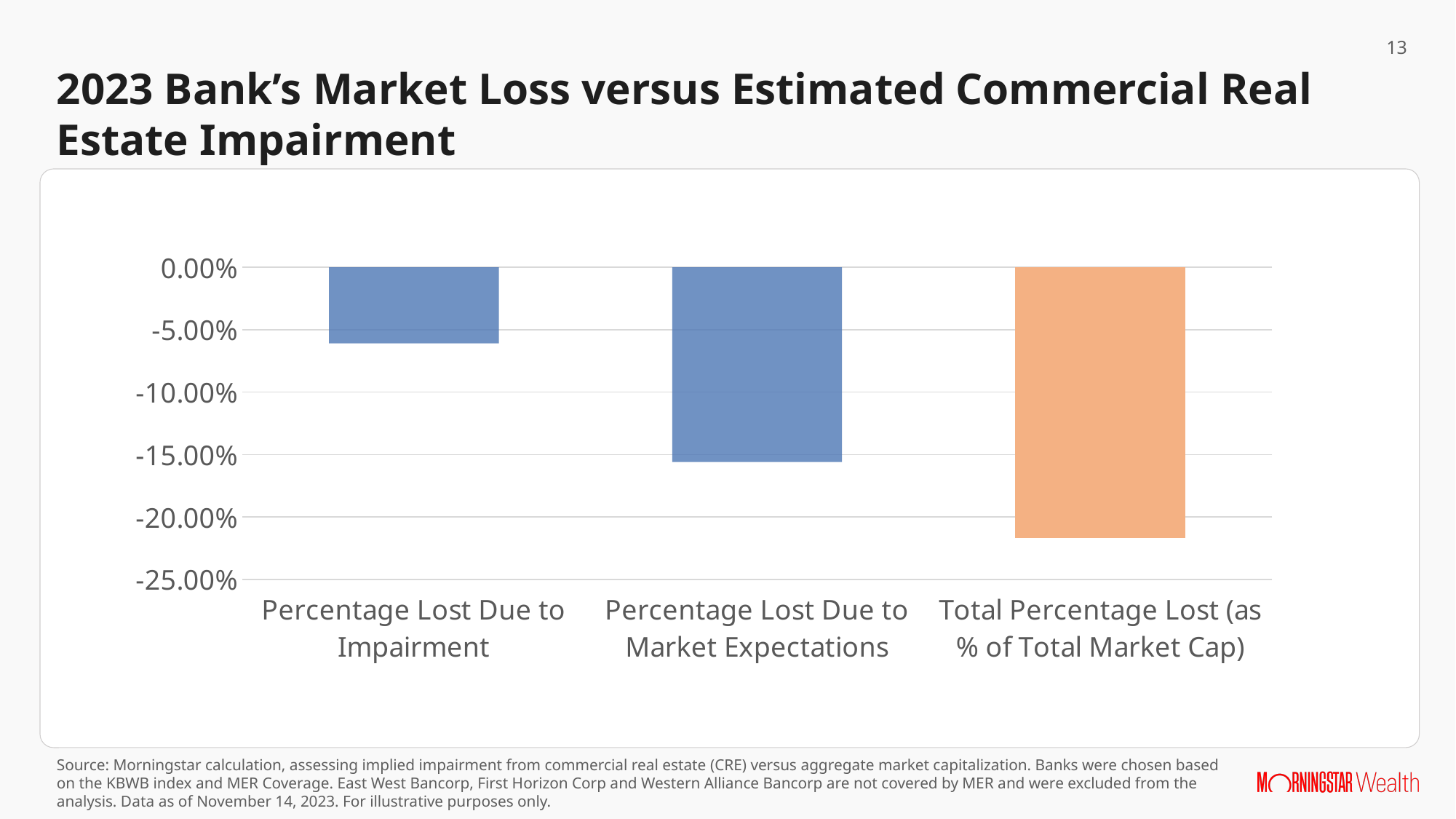
Which has the larger (less negative) value: Percentage Lost Due to Impairment or Percentage Lost Due to Market Expectations? Percentage Lost Due to Impairment What kind of chart is shown on the slide? bar chart Is the value for Percentage Lost Due to Impairment greater or less than -5.00%? less Is the value for Percentage Lost Due to Market Expectations greater or less than -20.00%? greater Is the value for Percentage Lost Due to Impairment greater or less than -10.00%? greater Which category has the highest (least negative) value in the chart? Percentage Lost Due to Impairment What is the title of the slide containing the chart? 2023 Bank's Market Loss versus Estimated Commercial Real Estate Impairment Which bar in the chart is coloured orange? Total Percentage Lost (as % of Total Market Cap) How many categories are plotted in the chart? 3 Which category has the lowest (most negative) value in the chart? Total Percentage Lost (as % of Total Market Cap)